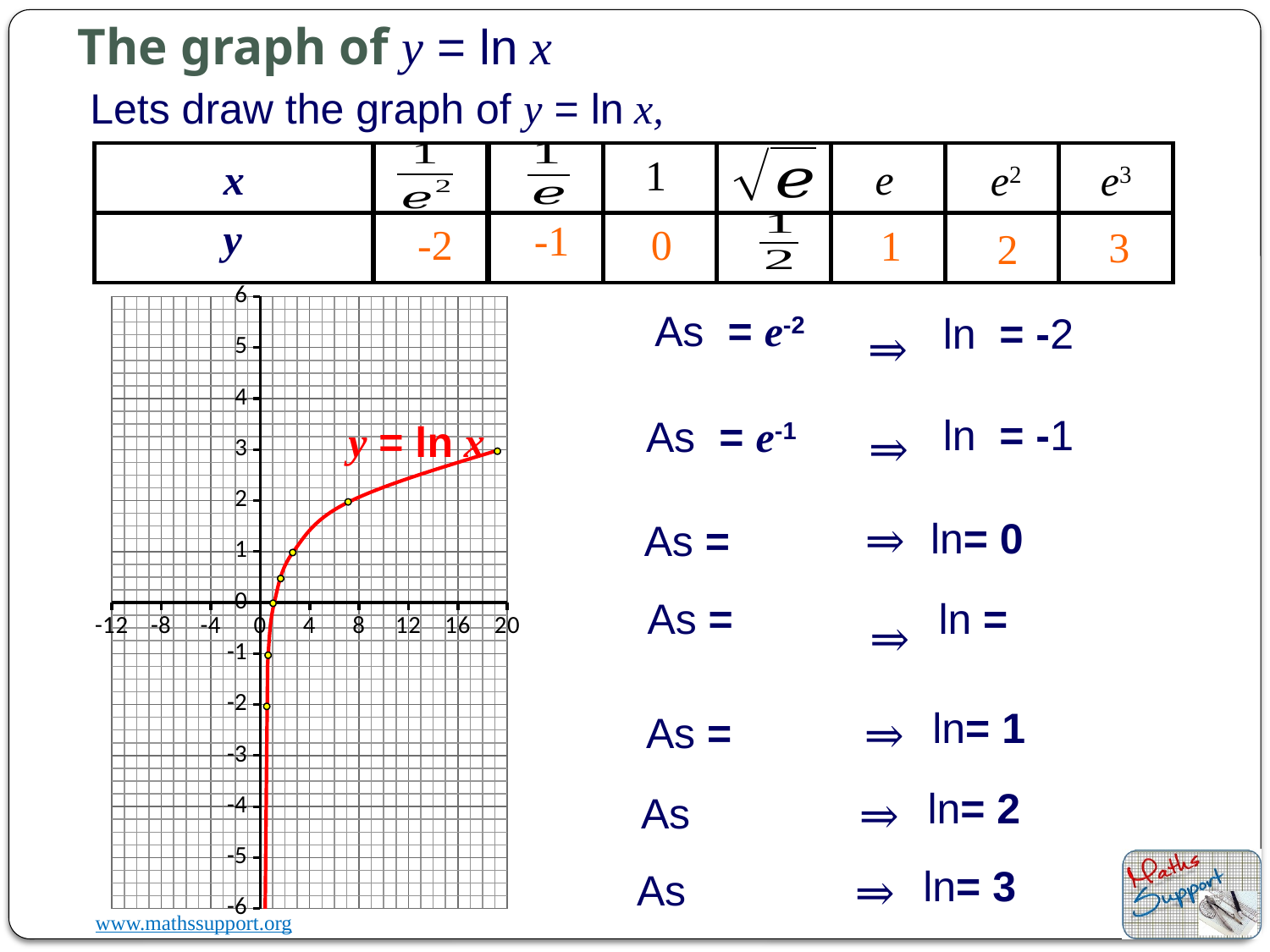
Is the value of the curve at x = 8 greater or less than 3? less What is the difference between the y value at x = e^3 and the y value at x = 1/e^2? 5 What is the lowest y value among the tabulated points? -2 What is the highest y value among the tabulated points? 3 According to the table, what is the value of y when x = 1/e? -1 According to the table, what is the value of y when x = e^2? 2 What equation is written as the label on the red curve? y = ln x What colour is the curve of y = ln x drawn in? red According to the table, what is the value of y when x = 1? 0 What kind of chart is shown on the slide? line chart How many points are marked on the curve? 7 Do the y values of the curve rise or fall as x increases along the x axis? rise